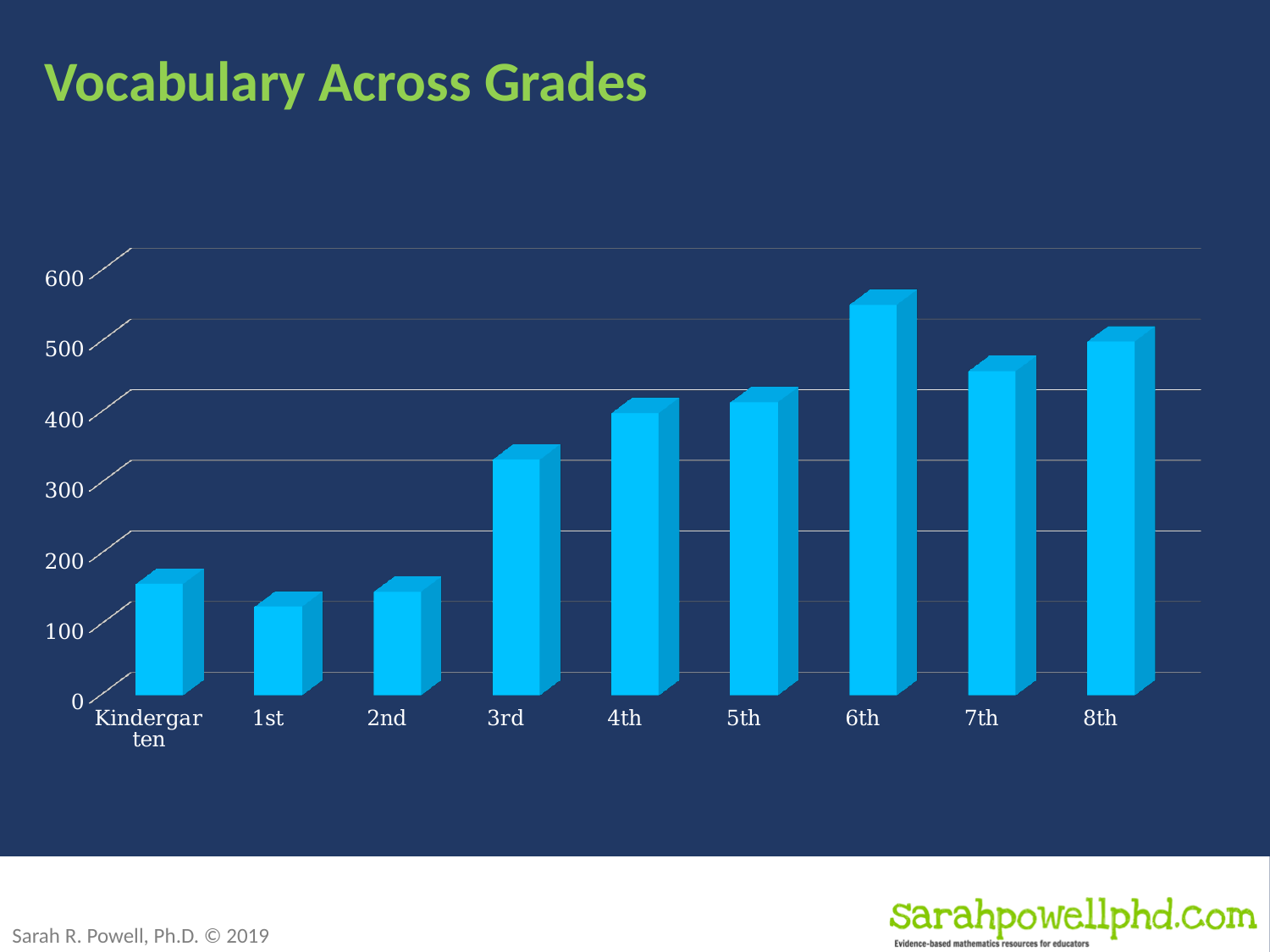
Which is larger, the value for 2nd grade or the value for 3rd grade? 3rd What is the title of the chart? Vocabulary Across Grades Is the value for 1st grade greater or less than 200? less Do the values generally rise or fall from Kindergarten to 8th grade? rise Is the value for 6th grade greater or less than 500? greater What kind of chart is shown on the slide? bar chart Which grade has the highest bar? 6th How many grade categories are plotted on the x axis? 9 Is the value for 3rd grade greater or less than 300? greater Which grade has the lowest bar? 1st Which is larger, the value for 6th grade or the value for 8th grade? 6th